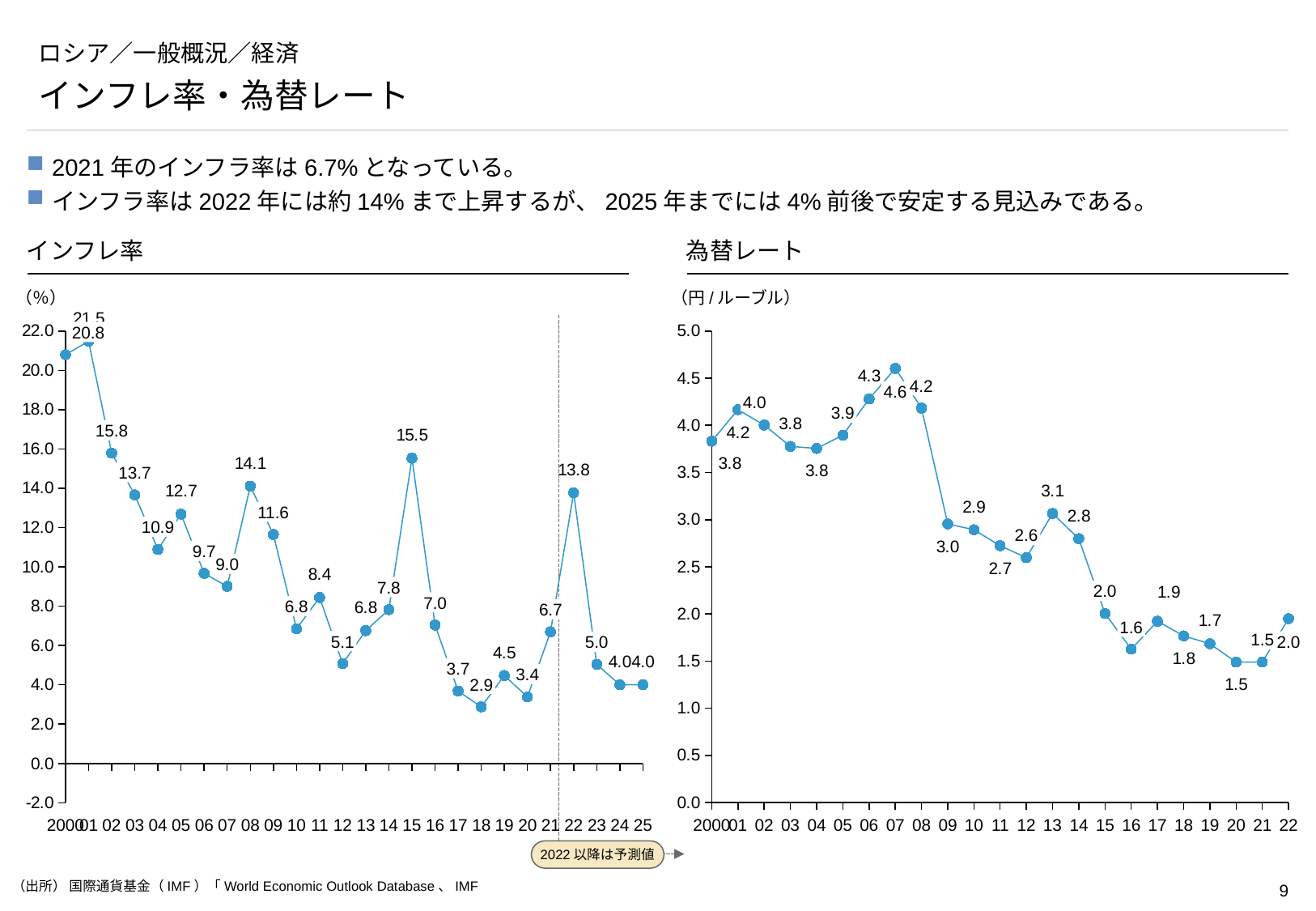
In the 為替レート chart, what is the value for 2022? 2.0 In the インフレ率 chart, what is the value for 2021? 6.7 In the 為替レート chart, what is the unit shown on the axis label? 円/ルーブル In the 為替レート chart, which year has the highest value? 2007 In the インフレ率 chart, what is the difference between the 2022 value and the 2021 value? 7.1 In the 為替レート chart, what is the value for 2007? 4.6 What kind of chart is the 為替レート chart? Line chart In the インフレ率 chart, which year has the lowest inflation rate? 2018 In the インフレ率 chart, what is the inflation rate for 2015? 15.5 In the インフレ率 chart, which year has the highest inflation rate? 2001 In the 為替レート chart, which is larger, the value for 2013 or the value for 2014? 2013 In the インフレ率 chart, what is the forecast value for 2022? 13.8